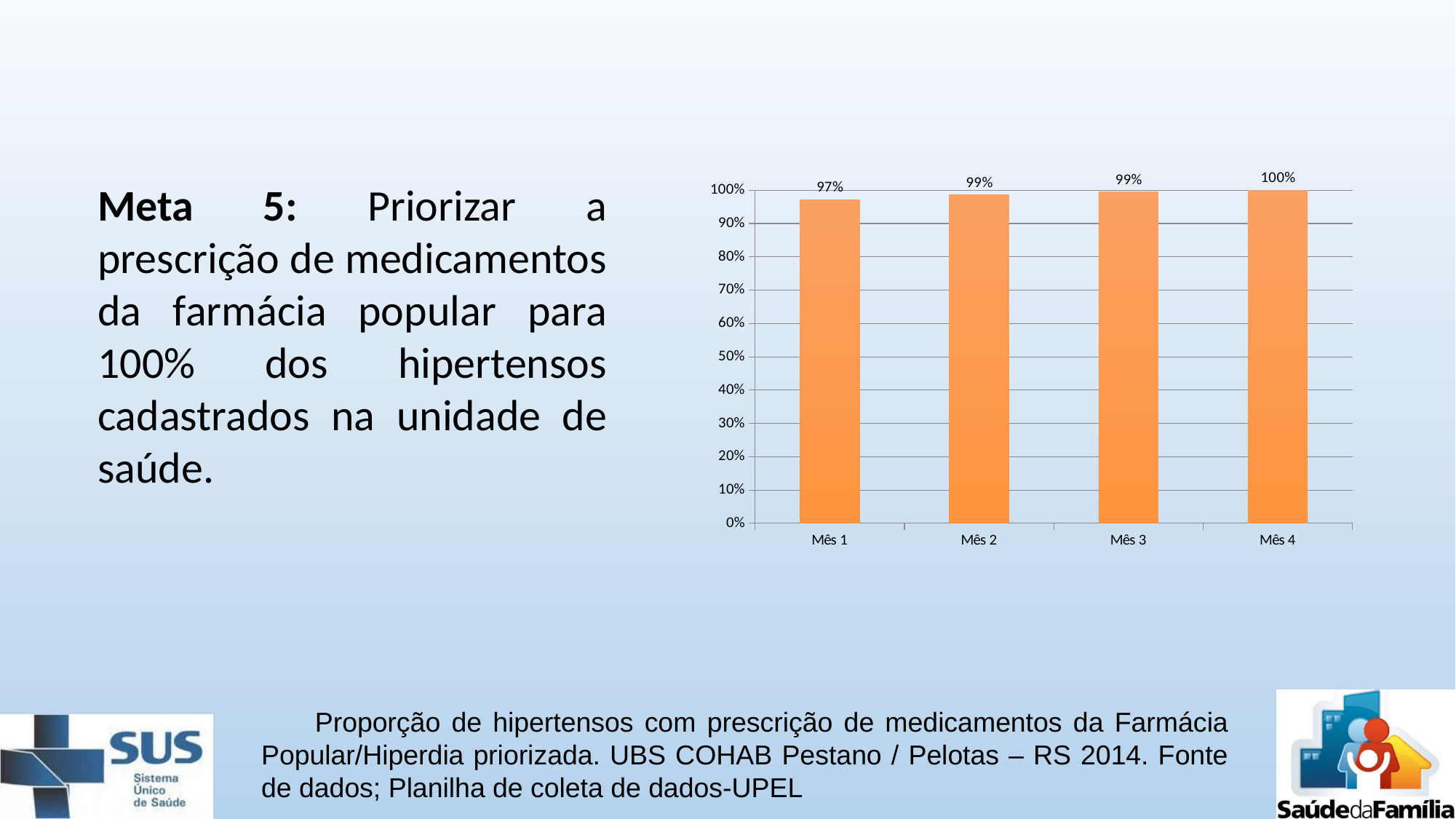
How many months are shown on the x axis? 4 What is the value for Mês 4? 100% What colour are the bars in the chart? orange Is the value for Mês 1 greater or less than 90%? greater What is the value for Mês 2? 99% What is the value for Mês 1? 97% What is the difference between the values for Mês 4 and Mês 1? 3% Which is larger, the value for Mês 1 or the value for Mês 3? Mês 3 What kind of chart is shown on the slide? bar chart Do the values rise or fall from Mês 1 to Mês 4? rise Which month has the lowest value? Mês 1 Which month has the highest value? Mês 4